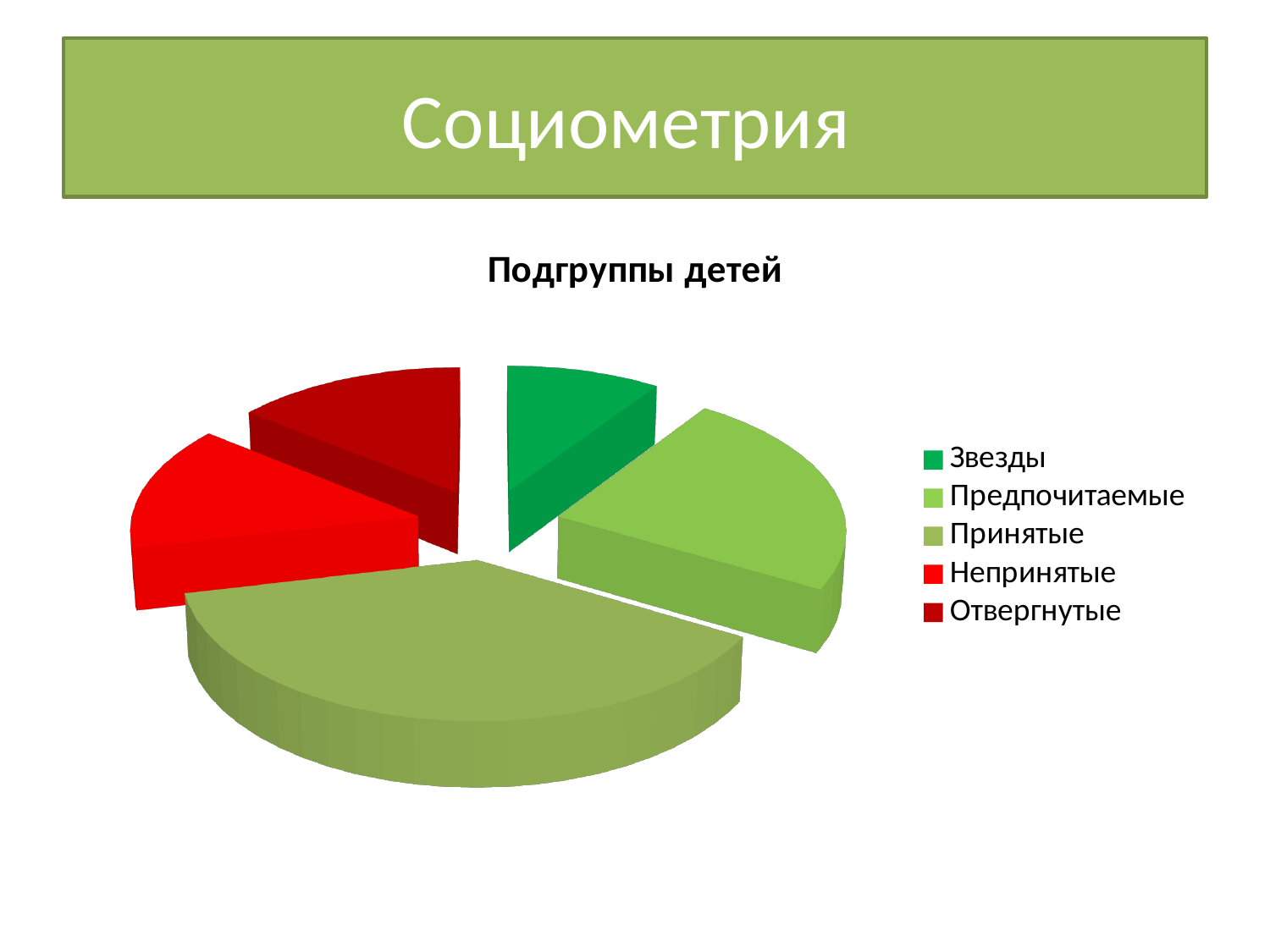
What colour is the Отвергнутые slice? dark red Which slice is larger, Предпочитаемые or Отвергнутые? Предпочитаемые What kind of chart is shown on the slide? pie chart How many categories (slices) does the pie chart have? 5 Which slice is larger, Принятые or Предпочитаемые? Принятые What is the title of the chart? Подгруппы детей How many entries does the legend list? 5 Which slice is larger, Принятые or Непринятые? Принятые Which category has the largest slice of the pie? Принятые